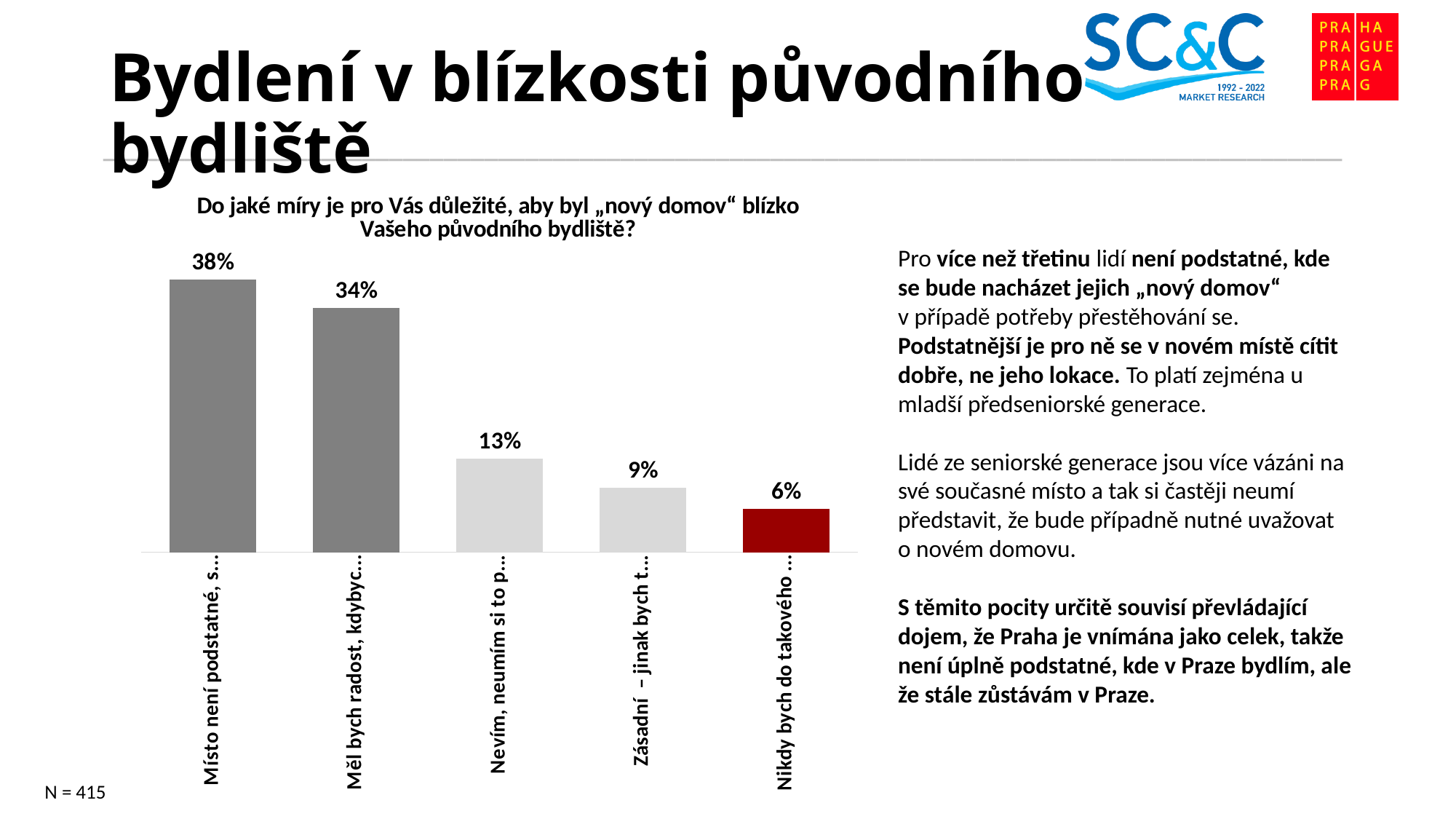
Which category has the lowest value in the chart? Nikdy bych do takového ... What value is shown for the bar labelled "Nikdy bych do takového ..."? 6% What is the difference between the values for "Místo není podstatné, s..." and "Měl bych radost, kdybyc..."? 4% Which category has the highest value in the chart? Místo není podstatné, s... What value is shown for the bar labelled "Zásadní – jinak bych t..."? 9% How many bars are shown in the chart? 5 What value is shown for the bar labelled "Měl bych radost, kdybyc..."? 34% What value is shown for the bar labelled "Nevím, neumím si to p..."? 13% What kind of chart is shown on the slide? Bar chart Which is larger: the value for "Nevím, neumím si to p..." or the value for "Zásadní – jinak bych t..."? Nevím, neumím si to p... Do the values rise or fall from left to right across the bars? Fall What value is shown for the bar labelled "Místo není podstatné, s..."? 38%